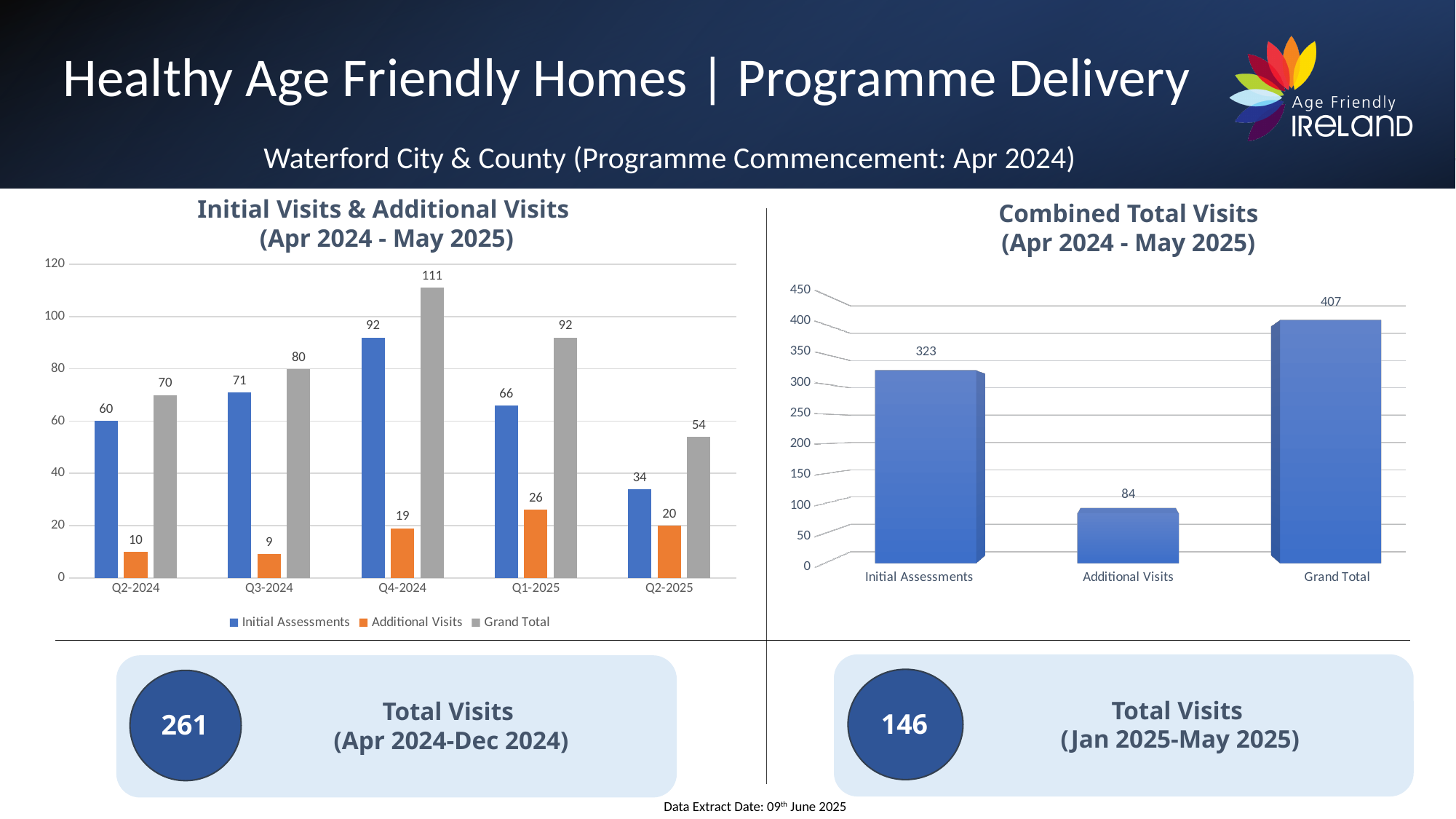
In the 'Initial Visits & Additional Visits' chart, which quarter has the lowest Additional Visits value? Q3-2024 In the 'Initial Visits & Additional Visits' chart, what is the difference between Initial Assessments in Q3-2024 and Q2-2024? 11 In the 'Initial Visits & Additional Visits' chart, what colour represents the Additional Visits series? Orange In the 'Combined Total Visits' chart, what is the difference between Grand Total and Initial Assessments? 84 How many quarters are shown on the x axis of the 'Initial Visits & Additional Visits' chart? 5 In the 'Initial Visits & Additional Visits' chart, what is the Grand Total for Q2-2025? 54 In the 'Initial Visits & Additional Visits' chart, which quarter has the highest Grand Total? Q4-2024 What kind of chart is the 'Combined Total Visits' chart? Bar chart In the 'Initial Visits & Additional Visits' chart, which is larger: Additional Visits in Q1-2025 or in Q2-2025? Q1-2025 How many series does the legend of the 'Initial Visits & Additional Visits' chart list? 3 In the 'Combined Total Visits' chart, what is the value for Additional Visits? 84 In the 'Initial Visits & Additional Visits' chart, what is the value of Initial Assessments for Q4-2024? 92